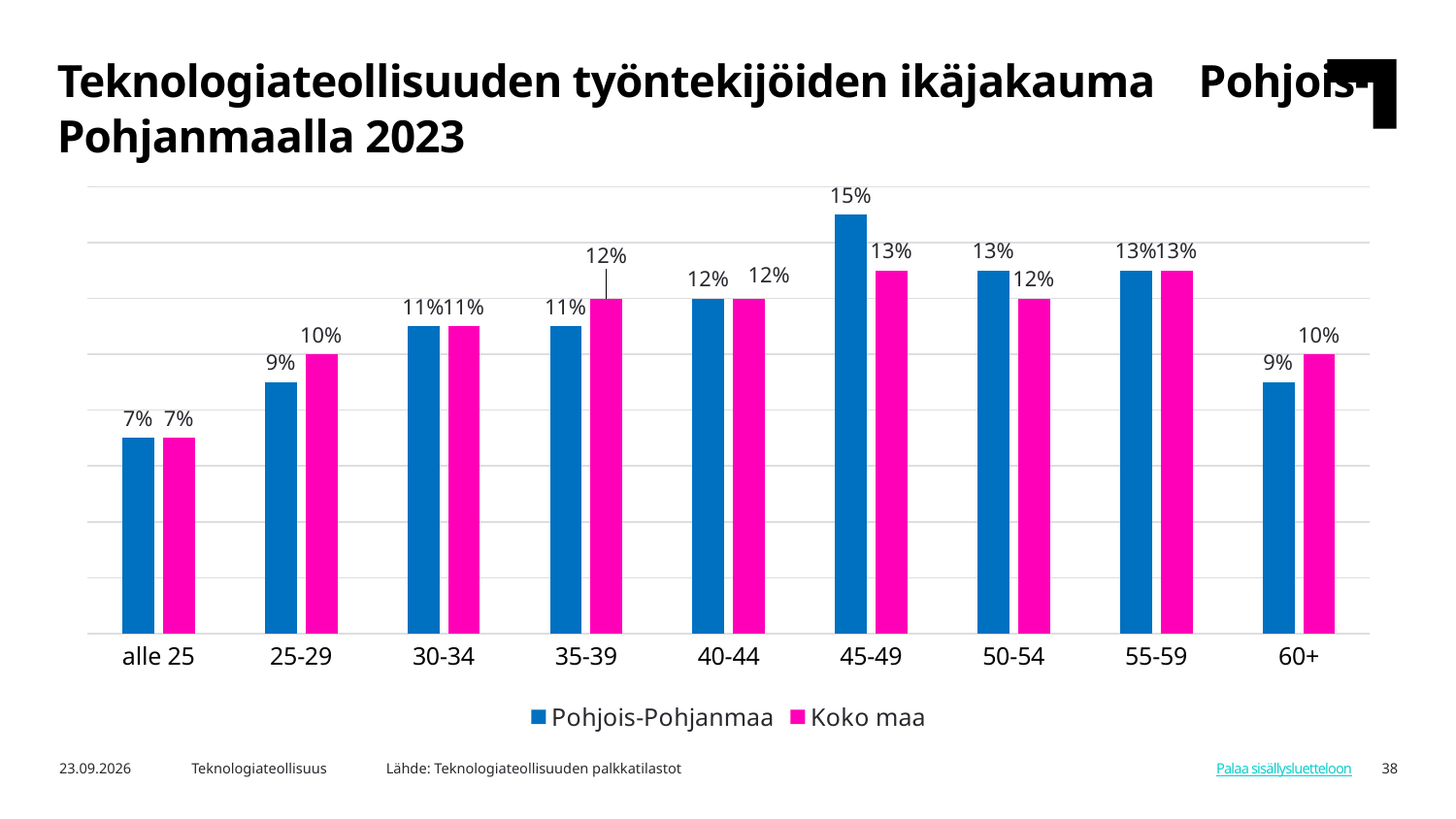
What is the value for Pohjois-Pohjanmaa in the 60+ age group? 9% Which age group has the lowest value for Koko maa? alle 25 What is the value for Koko maa in the 35-39 age group? 12% What is the difference between the Pohjois-Pohjanmaa and Koko maa values in the 45-49 age group? 2 percentage points Which colour represents Koko maa in the chart? Pink In the 50-54 age group, which series has the larger value, Pohjois-Pohjanmaa or Koko maa? Pohjois-Pohjanmaa Which age group has the highest value for Pohjois-Pohjanmaa? 45-49 What is the value for Koko maa in the 25-29 age group? 10% What is the value for Pohjois-Pohjanmaa in the 45-49 age group? 15% How many series does the legend list? 2 What kind of chart is shown on the slide? Bar chart How many age groups are shown on the x axis? 9